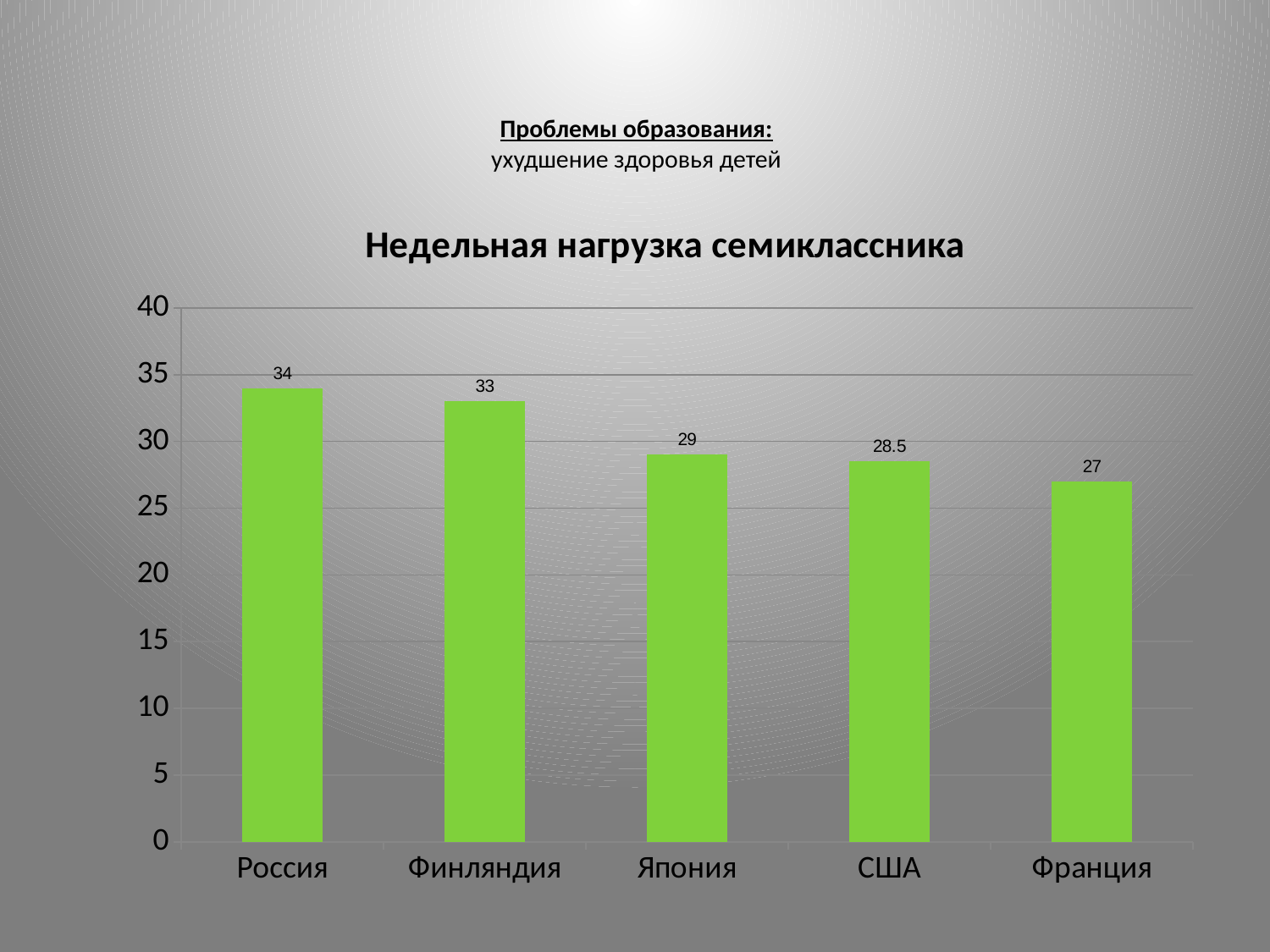
Which category has the highest value? Россия Which is larger, the value for Финляндия or the value for Япония? Финляндия How many categories are shown on the x axis? 5 What is the value for Франция? 27 What kind of chart is this? bar chart What is the value for Россия? 34 Is the value for Япония greater or less than 30? less What is the value for США? 28.5 What is the difference between the values for Япония and США? 0.5 What is the title of the chart? Недельная нагрузка семиклассника Which category has the lowest value? Франция What is the difference between the values for Россия and Франция? 7